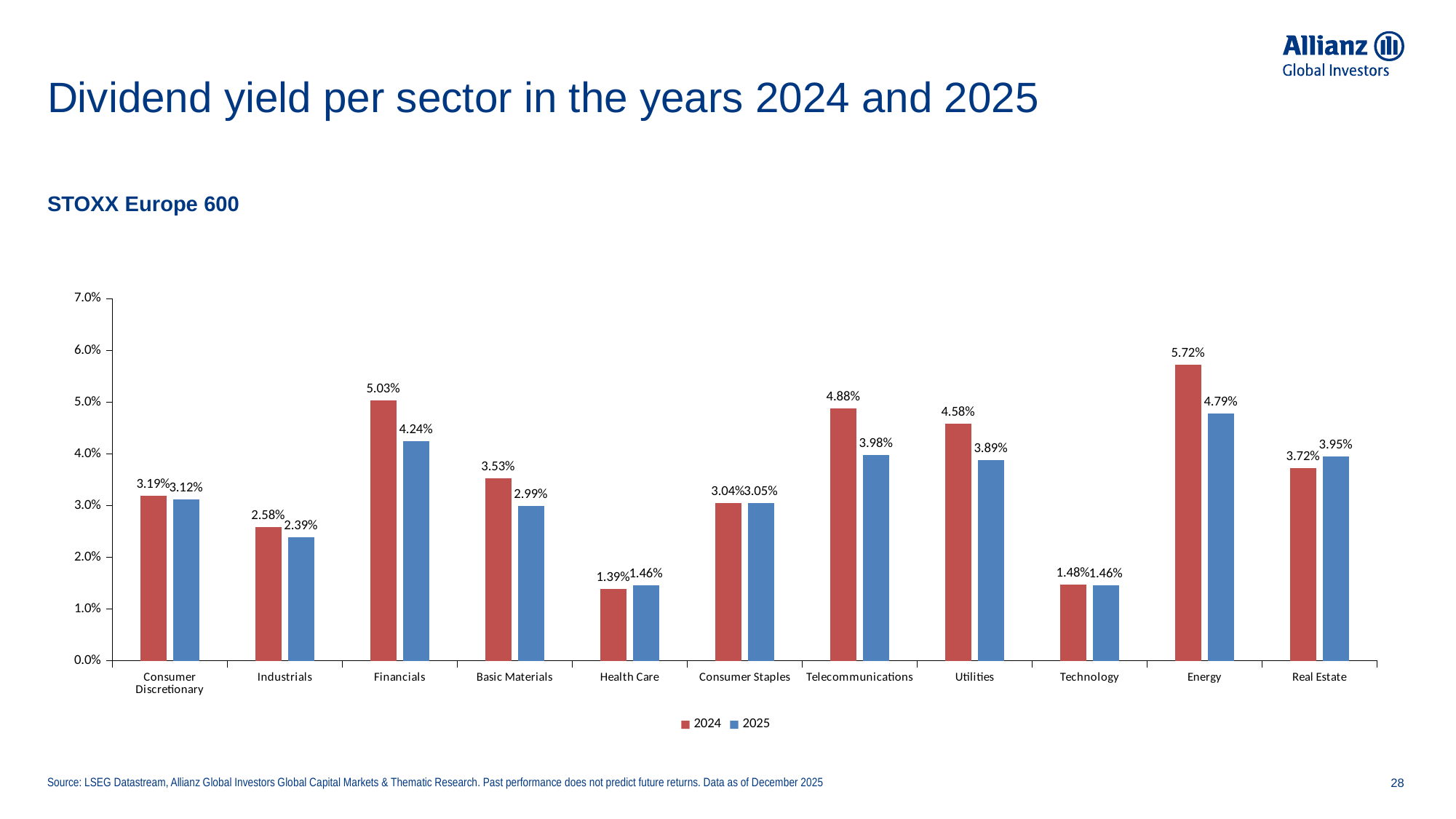
Which sector has the lowest dividend yield in 2025? Health Care and Technology (tied at 1.46%) Is the 2024 dividend yield for Basic Materials greater or less than 3.0%? greater How many series does the legend list? 2 What is the difference between the 2024 and 2025 dividend yields for Energy? 0.93% Which sector has the highest dividend yield in 2024? Energy What is the dividend yield for Real Estate in 2025? 3.95% What kind of chart is shown on the slide? Bar chart Which is larger for Utilities: the 2024 or the 2025 dividend yield? 2024 What is the dividend yield for Financials in 2024? 5.03% Which index does the chart cover, according to the subtitle? STOXX Europe 600 What is the dividend yield for Telecommunications in 2025? 3.98% How many sectors are shown on the x axis? 11